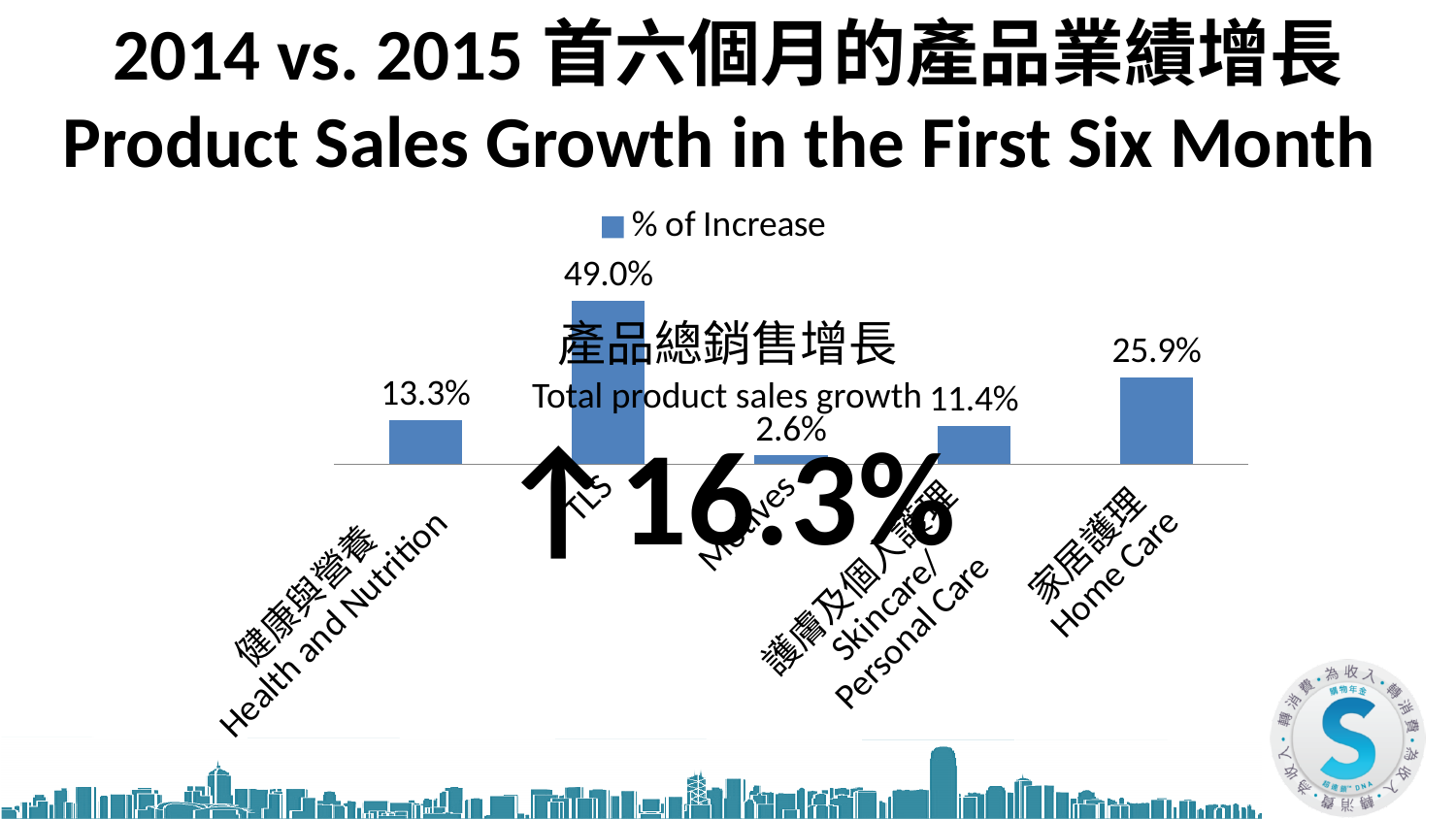
What is the % of Increase for Health and Nutrition? 13.3% Which product category has the lowest % of Increase? Motives Which has a larger % of Increase, Health and Nutrition or Skincare/Personal Care? Health and Nutrition What is the total product sales growth figure shown over the chart? 16.3% How many series does the legend list? 1 What is the % of Increase for TLS? 49.0% How many product categories are shown in the chart? 5 What kind of chart is shown on the slide? Bar chart Which product category has the highest % of Increase? TLS What is the % of Increase for Skincare/Personal Care? 11.4% What is the difference in % of Increase between Home Care and Health and Nutrition? 12.6% What is the % of Increase for Home Care? 25.9%